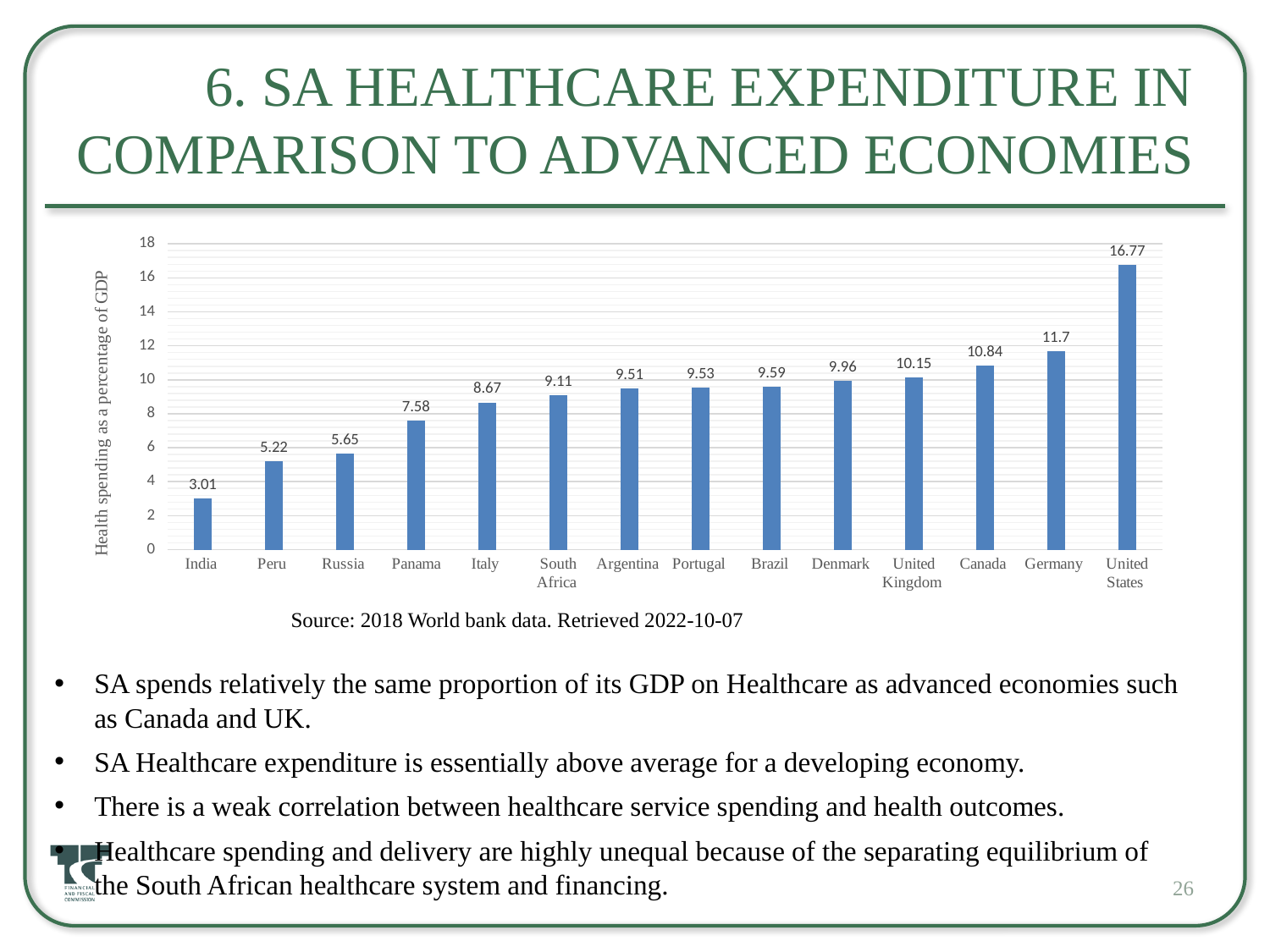
What is the health spending as a percentage of GDP for the United Kingdom? 10.15 Which country has the highest health spending as a percentage of GDP? United States What is the difference between the values for the United States and South Africa? 7.66 How many countries are shown in the chart? 14 What is the value shown for Germany? 11.7 What is the health spending as a percentage of GDP for South Africa? 9.11 Is the value for Peru greater or less than 6? less Which has a higher value, Panama or Italy? Italy What is the difference between the values for Canada and the United Kingdom? 0.69 What is the label of the vertical axis? Health spending as a percentage of GDP Which country has the lowest health spending as a percentage of GDP? India What kind of chart is shown on the slide? Bar chart